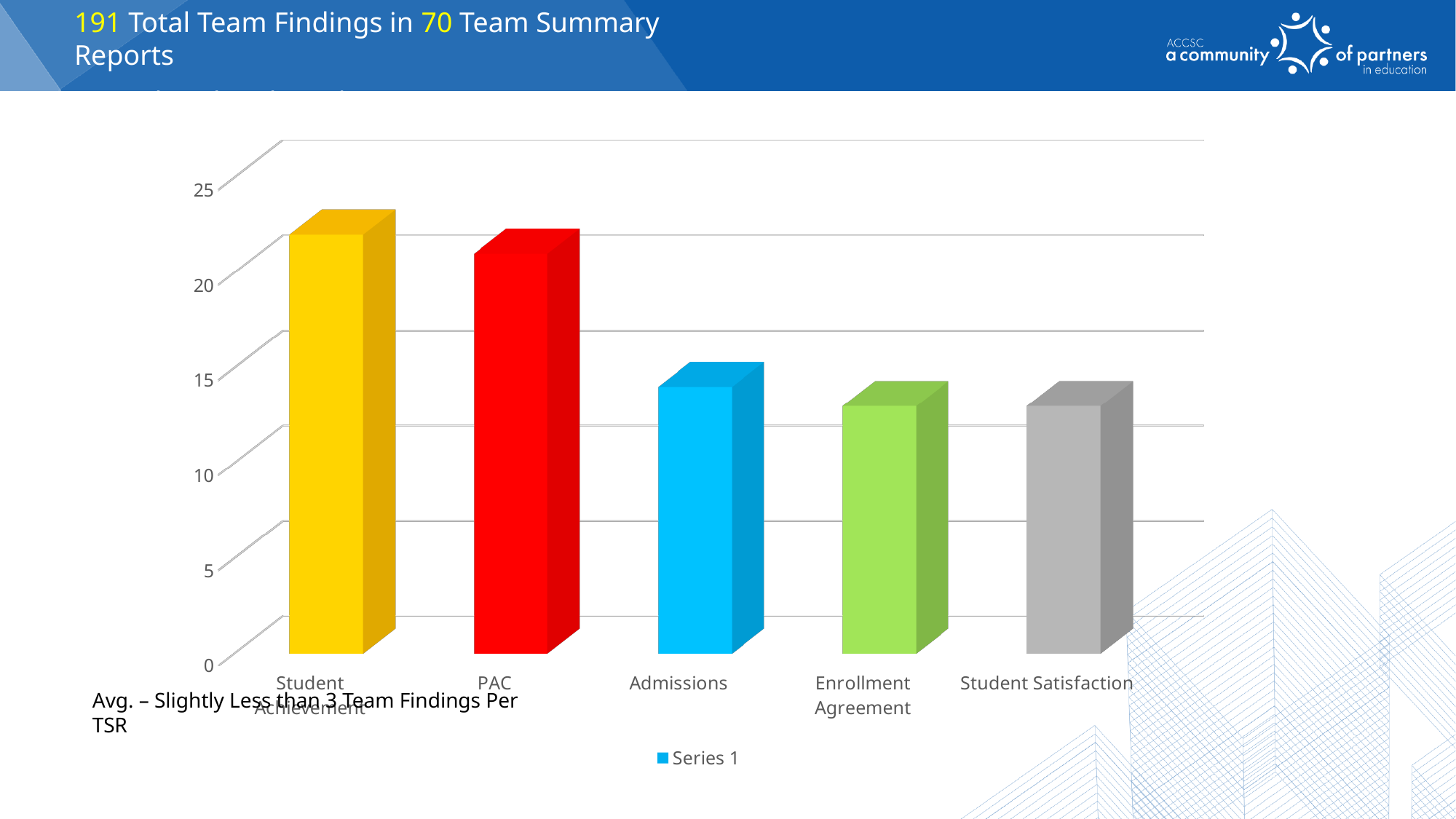
Is the value for Student Achievement greater or less than 20? greater Is the value for Enrollment Agreement greater or less than 15? less What kind of chart is shown on the slide? bar chart What is the name of the series shown in the chart legend? Series 1 Is the value for Student Satisfaction greater or less than 10? greater Which is larger, the value for PAC or the value for Admissions? PAC How many series does the chart legend list? 1 Do the values generally rise or fall moving from left to right across the categories? fall Which category has the highest value on the chart? Student Achievement How many categories are plotted on the chart? 5